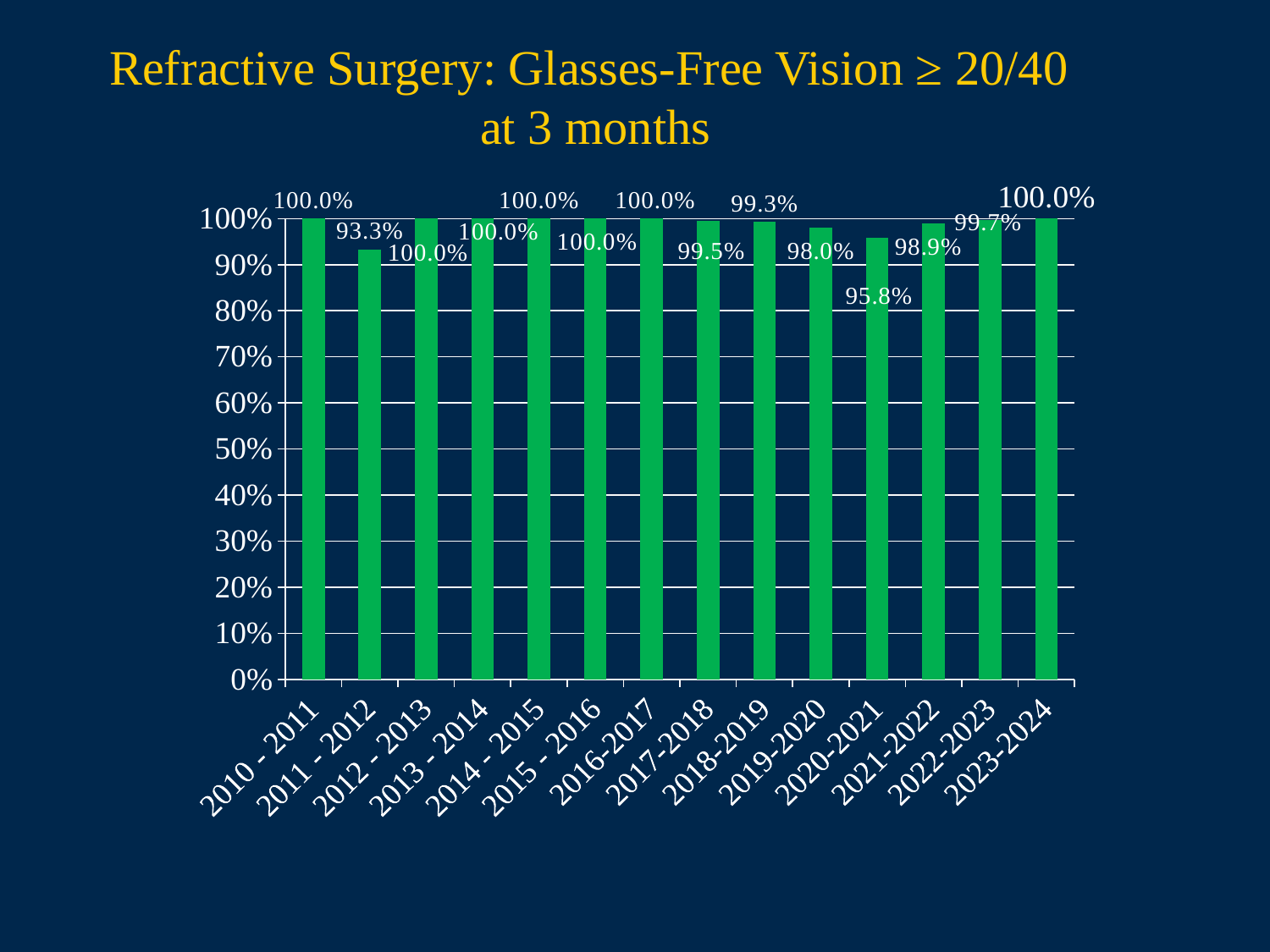
What kind of chart is shown on the slide? bar chart What is the value for 2022-2023? 99.7% How many academic years are shown on the x axis? 14 Do the values rise or fall from 2017-2018 to 2020-2021? fall What is the difference between the values for 2021-2022 and 2020-2021? 3.1% What is the difference between the values for 2010 - 2011 and 2011 - 2012? 6.7% Which is larger, the value for 2019-2020 or the value for 2020-2021? 2019-2020 What is the value for 2019-2020? 98.0% What is the value for 2020-2021? 95.8% Which academic year has the lowest value? 2011 - 2012 What is the value for 2011 - 2012? 93.3% Is the value for 2011 - 2012 greater or less than 90%? greater